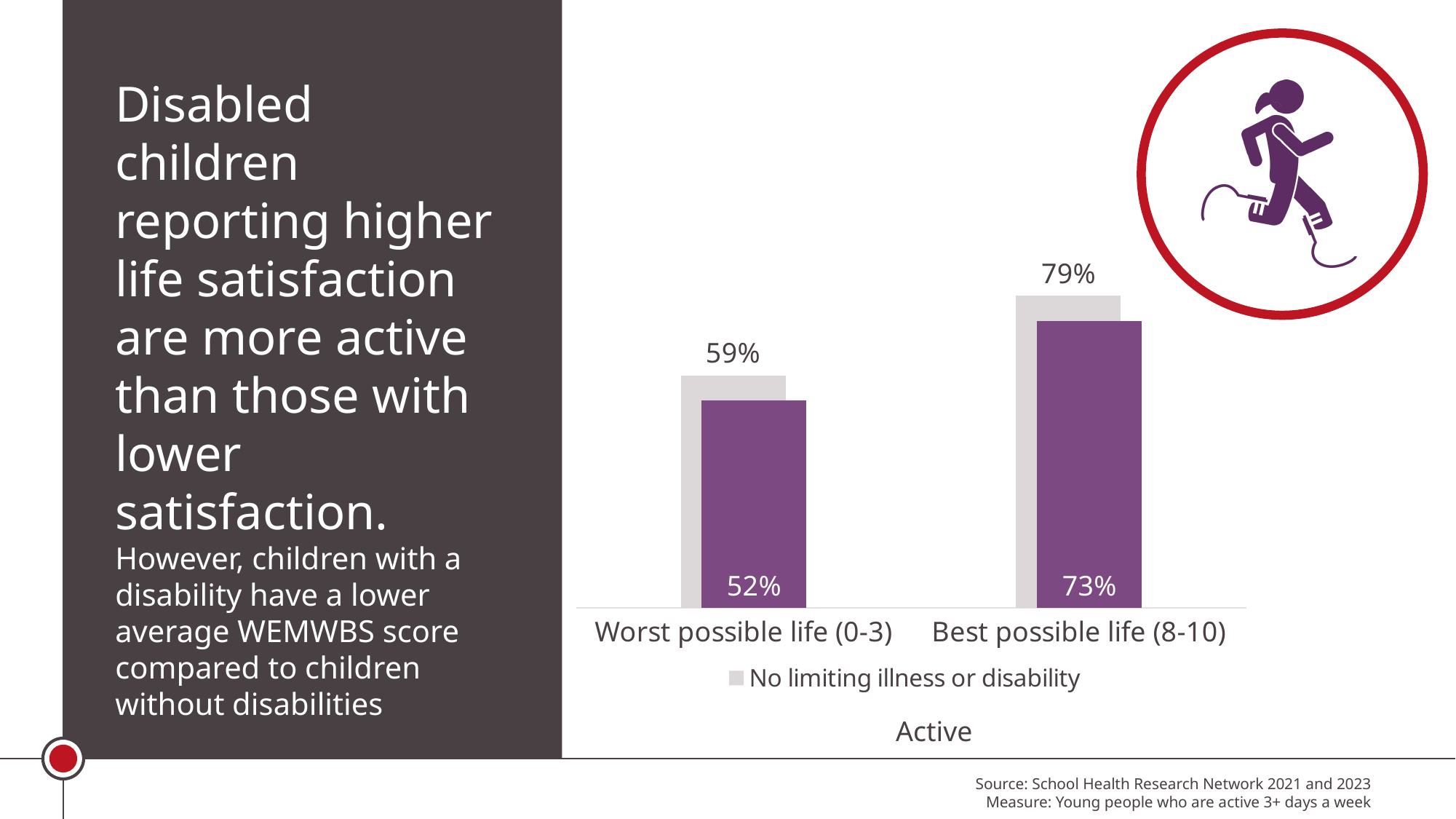
What is the value for 'No limiting illness or disability' in the 'Best possible life (8-10)' category? 79% What is the value of the purple bar in the 'Worst possible life (0-3)' category? 52% What is the value for 'No limiting illness or disability' in the 'Worst possible life (0-3)' category? 59% What is the difference between the 'No limiting illness or disability' values for 'Best possible life (8-10)' and 'Worst possible life (0-3)'? 20 percentage points How many categories are shown on the x axis of the chart? 2 What is the value of the purple bar in the 'Best possible life (8-10)' category? 73% What is the difference between the purple bar values for 'Best possible life (8-10)' and 'Worst possible life (0-3)'? 21 percentage points In the 'Worst possible life (0-3)' category, what is the difference between the grey bar and the purple bar? 7 percentage points Which bar is the lowest in the chart? Purple bar, Worst possible life (0-3) (52%) What kind of chart is shown on the slide? Bar chart Which is larger: the grey bar for 'Worst possible life (0-3)' or the purple bar for 'Best possible life (8-10)'? Purple bar for Best possible life (8-10) Which bar is the highest in the chart? No limiting illness or disability, Best possible life (8-10) (79%)